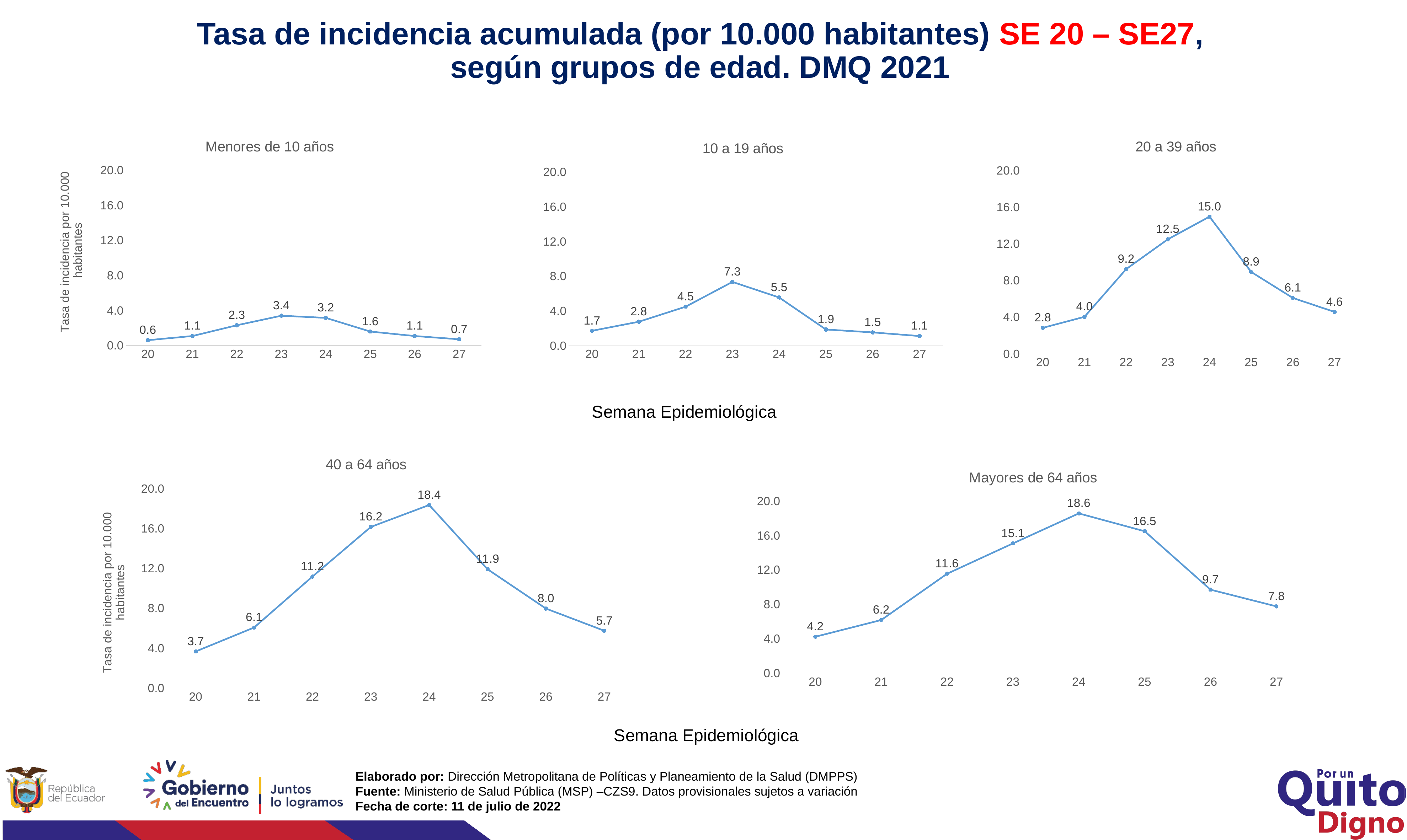
In the '10 a 19 años' chart, which week has the highest value? 23 In the 'Mayores de 64 años' chart, which week has the lowest value? 20 In the '40 a 64 años' chart, what is the difference between the values for week 24 and week 27? 12.7 In the '10 a 19 años' chart, do the values rise or fall from week 23 to week 27? Fall How many weeks are plotted on the x axis of the '40 a 64 años' chart? 8 In the 'Mayores de 64 años' chart, is the value for week 24 larger than the value for week 25? Yes, week 24 (18.6) is larger than week 25 (16.5) In the '20 a 39 años' chart, what is the difference between the values for week 23 and week 22? 3.3 What kind of chart is the '20 a 39 años' chart? Line chart How many charts are shown on the slide? 5 In the 'Menores de 10 años' chart, what is the value for week 23? 3.4 In the 'Menores de 10 años' chart, what is the value for week 20? 0.6 In the '20 a 39 años' chart, what is the value for week 24? 15.0